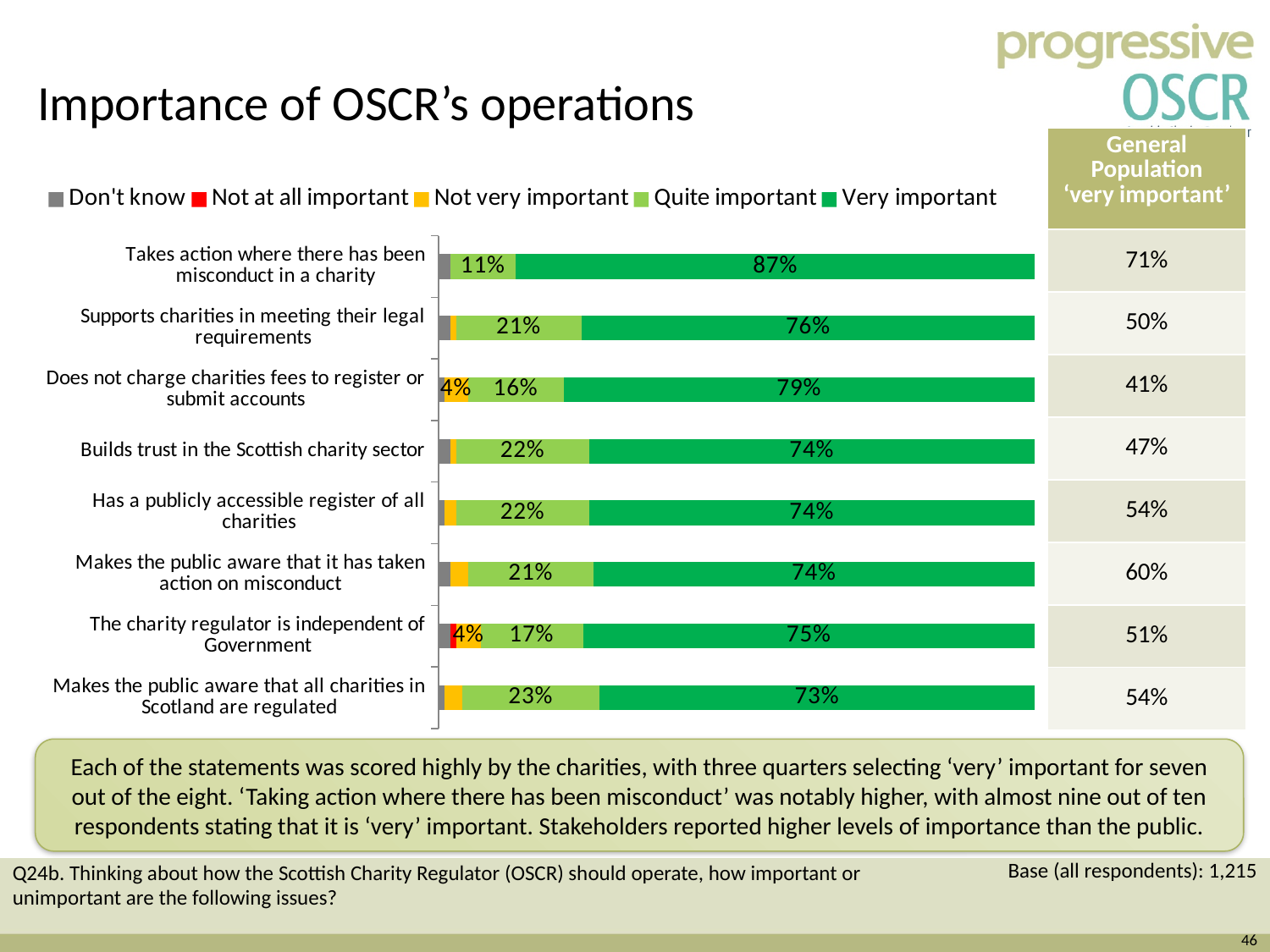
What is the 'Not very important' value shown for 'Does not charge charities fees to register or submit accounts'? 4% Which statement has the highest 'Very important' percentage? Takes action where there has been misconduct in a charity Which statement has the lowest 'Very important' percentage? Makes the public aware that all charities in Scotland are regulated Which legend entry is shown in red? Not at all important What percentage rated 'Makes the public aware that all charities in Scotland are regulated' as quite important? 23% What percentage of respondents rated 'Takes action where there has been misconduct in a charity' as very important? 87% How many series does the legend list? 5 How many statements are shown in the chart? 8 What is the difference between the 'Very important' values for 'Takes action where there has been misconduct in a charity' and 'Supports charities in meeting their legal requirements'? 11% What type of chart is shown on the slide? Stacked bar chart Which has a larger 'Quite important' value: 'Builds trust in the Scottish charity sector' or 'The charity regulator is independent of Government'? Builds trust in the Scottish charity sector What is the 'Very important' value for 'Does not charge charities fees to register or submit accounts'? 79%